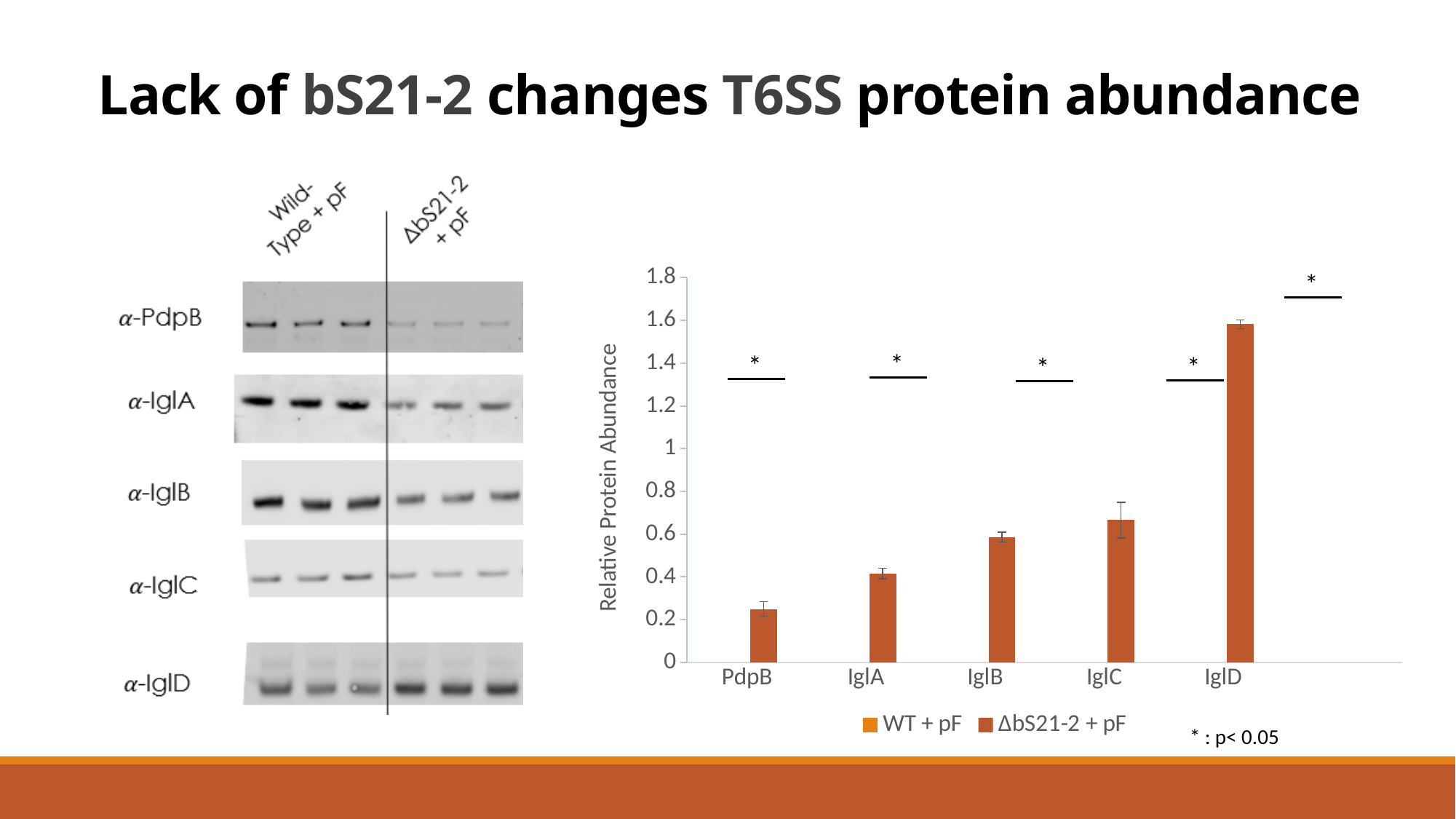
Do the bar heights rise or fall moving from PdpB to IglD along the x axis? rise In the bar chart, is the bar for IglB greater or less than 0.4? greater In the bar chart, is the bar for IglD greater or less than 1.4? greater In the bar chart, is the bar for IglC greater or less than 1? less How many categories are shown on the x axis of the bar chart? 5 In the bar chart, which bar is taller, IglA or IglB? IglB What kind of chart is shown on the right side of the slide? bar chart What is the title of the y axis of the bar chart? Relative Protein Abundance How many series does the legend of the bar chart list? 2 Which category has the lowest bar in the bar chart? PdpB Which category has the highest bar in the bar chart? IglD